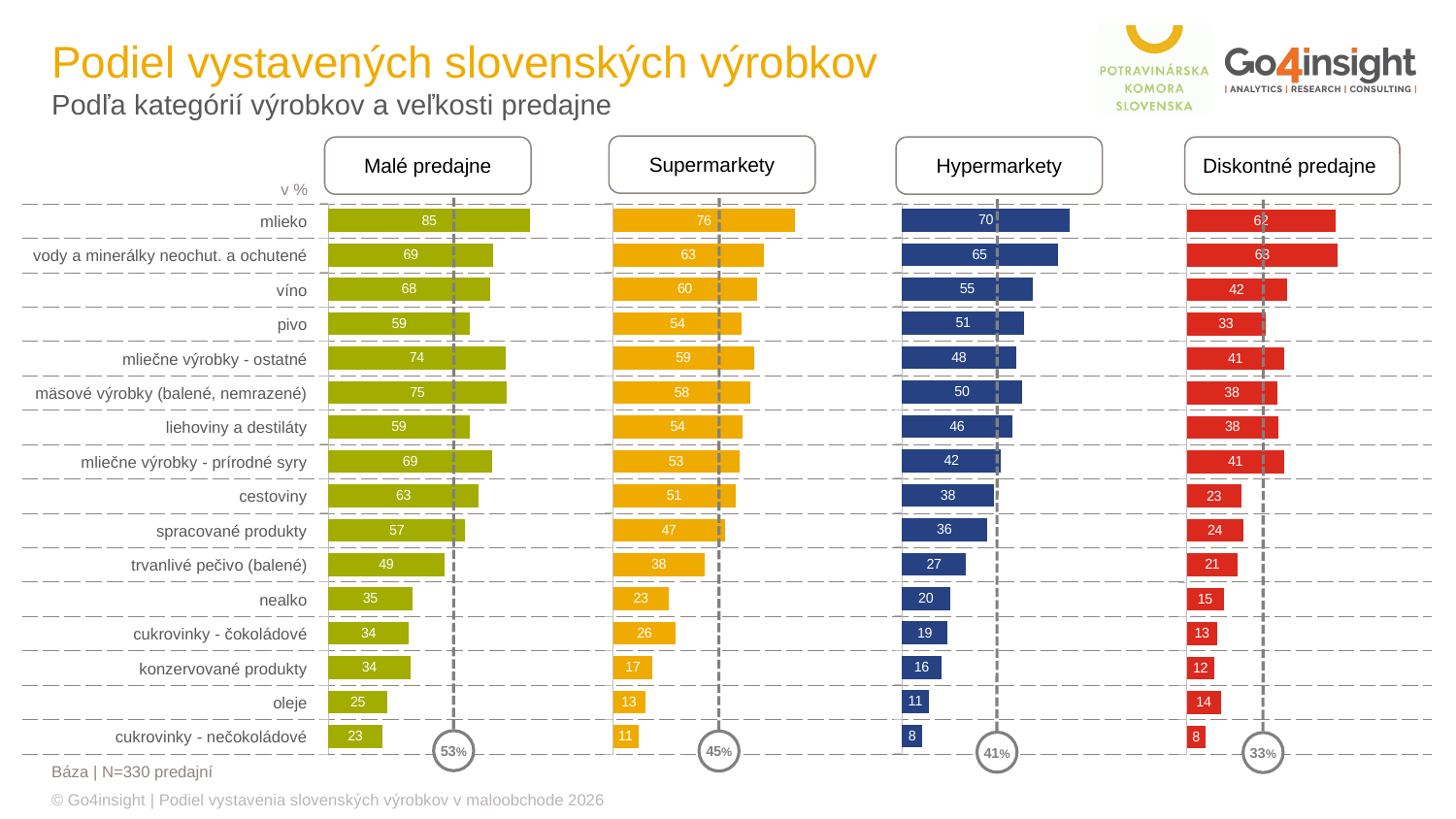
What type of chart is used for the Hypermarkety data? bar chart In the Supermarkety chart, which category has the lowest value? cukrovinky - nečokoládové In the Diskontné predajne chart, what is the value for pivo? 33 In the Hypermarkety chart, what is the difference between the values for mlieko and vody a minerálky neochut. a ochutené? 5 In the Supermarkety chart, what is the value for víno? 60 In the Malé predajne chart, what is the difference between the values for mlieko and oleje? 60 In the Diskontné predajne chart, which is larger: the value for víno or the value for cestoviny? víno How many product categories are listed in the Malé predajne chart? 16 In the Malé predajne chart, what is the value for mlieko? 85 What percentage is shown in the circle at the bottom of the Supermarkety chart? 45% In the Hypermarkety chart, which category has the highest value? mlieko In the Hypermarkety chart, what is the value for cestoviny? 38